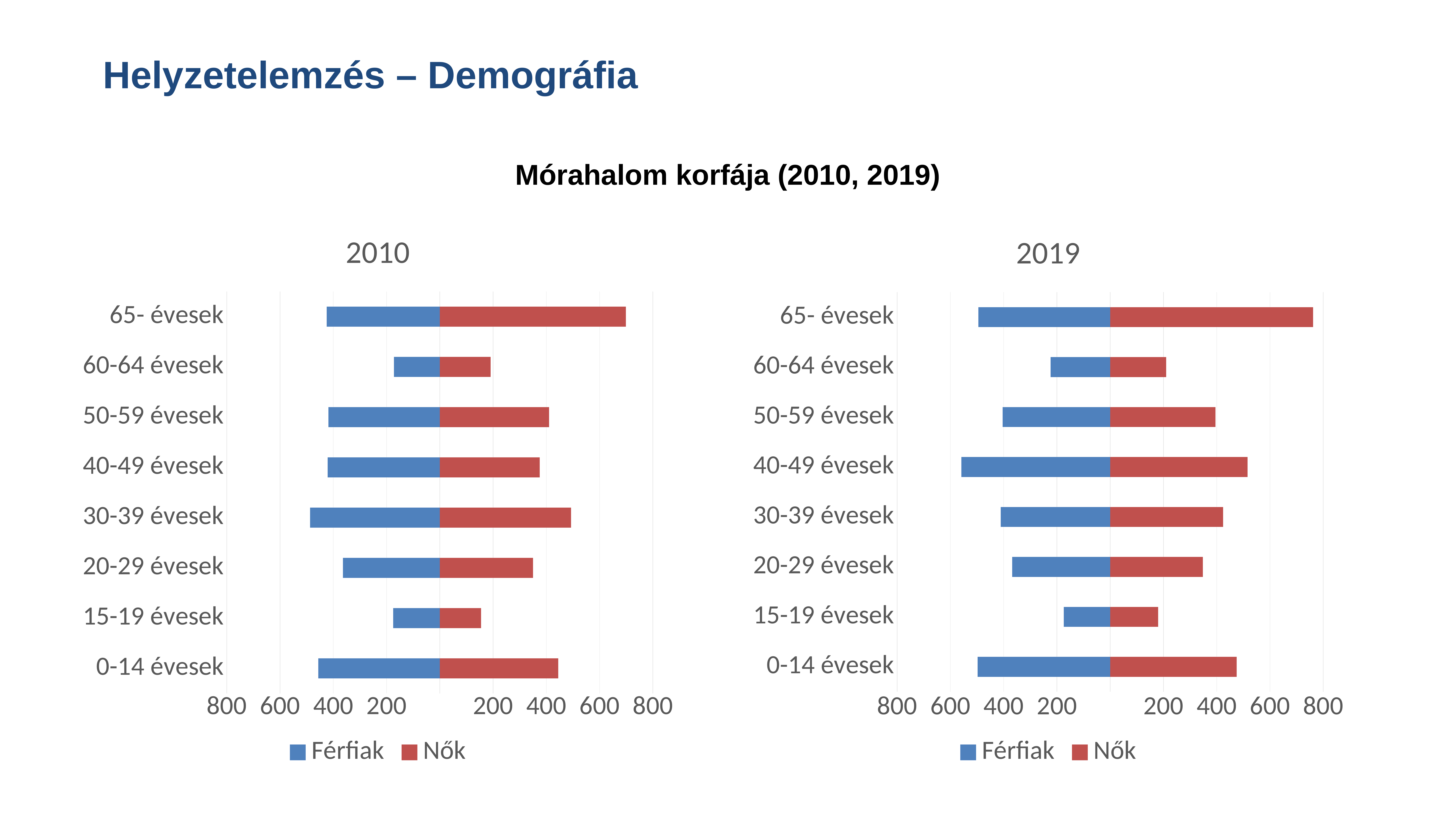
On the 2019 chart, which age group has the highest Férfiak value? 40-49 évesek What is the overall title above the two charts? Mórahalom korfája (2010, 2019) On the 2019 chart, which age group has the highest Nők value? 65- évesek On the 2019 chart, is the Nők value for 65- évesek greater or less than 600? greater On the 2010 chart, is the Férfiak value for 15-19 évesek greater or less than 200? less How many age groups are shown on the 2019 chart? 8 On the 2019 chart, is the Férfiak value for 40-49 évesek greater or less than 400? greater On the 2010 chart, which age group has the highest Nők value? 65- évesek What kind of chart is the 2010 chart? bar chart What are the two legend entries on the 2019 chart? Férfiak, Nők How many series does the legend of the 2010 chart list? 2